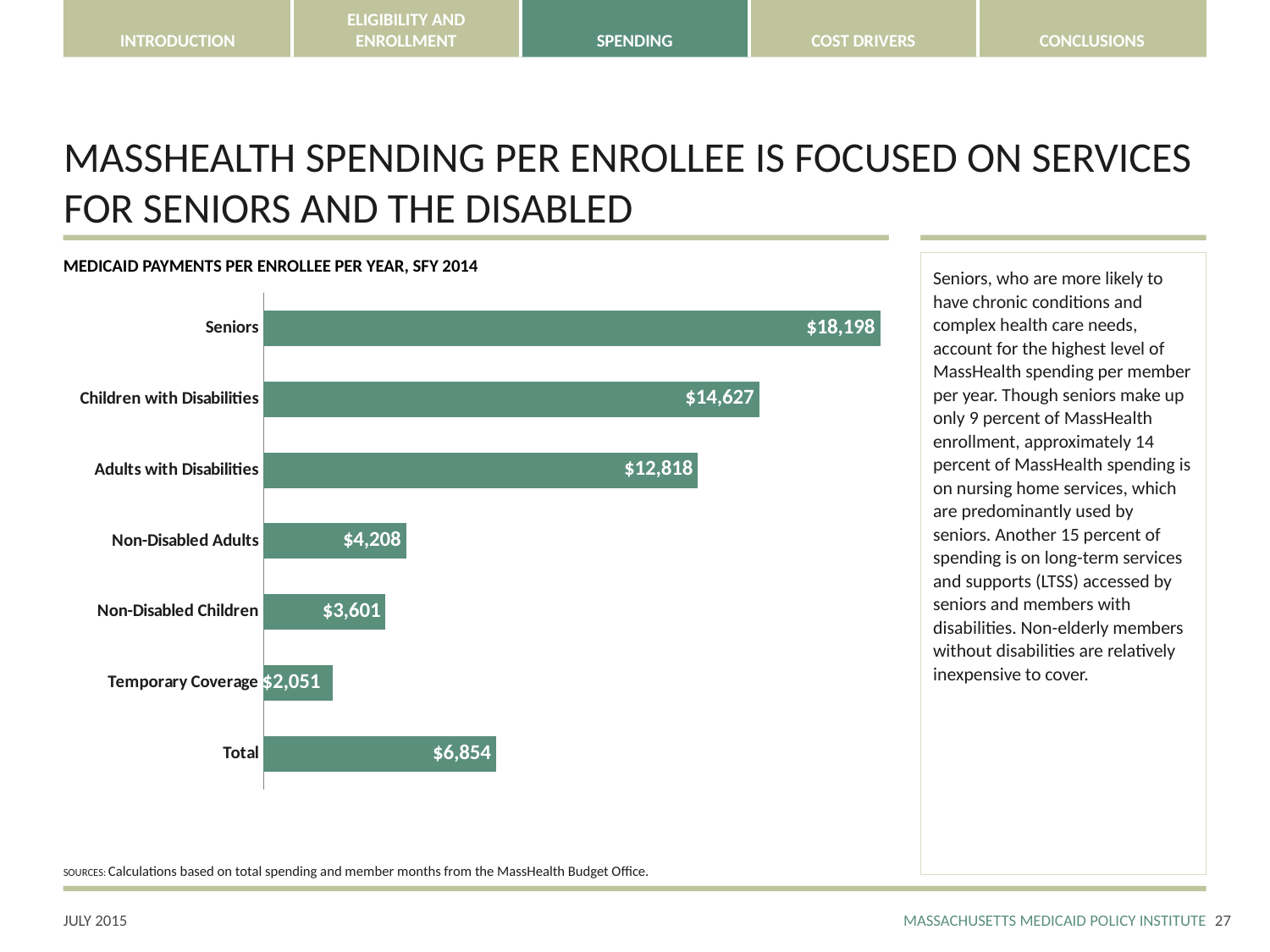
What kind of chart is shown on the slide? Bar chart Which category has the highest Medicaid payment per enrollee per year? Seniors What is the Medicaid payment per enrollee per year for Seniors? $18,198 What is the difference between the payment per enrollee for Seniors and for Adults with Disabilities? $5,380 What is the Medicaid payment per enrollee per year for Non-Disabled Children? $3,601 Which is larger: the payment per enrollee for Children with Disabilities or for Adults with Disabilities? Children with Disabilities What is the Total Medicaid payment per enrollee per year shown on the chart? $6,854 What is the Medicaid payment per enrollee per year for Children with Disabilities? $14,627 How many bars are shown on the chart? 7 Which category has the lowest Medicaid payment per enrollee per year? Temporary Coverage What is the title of the chart? Medicaid Payments per Enrollee per Year, SFY 2014 What is the difference between the payment per enrollee for Non-Disabled Adults and for Non-Disabled Children? $607